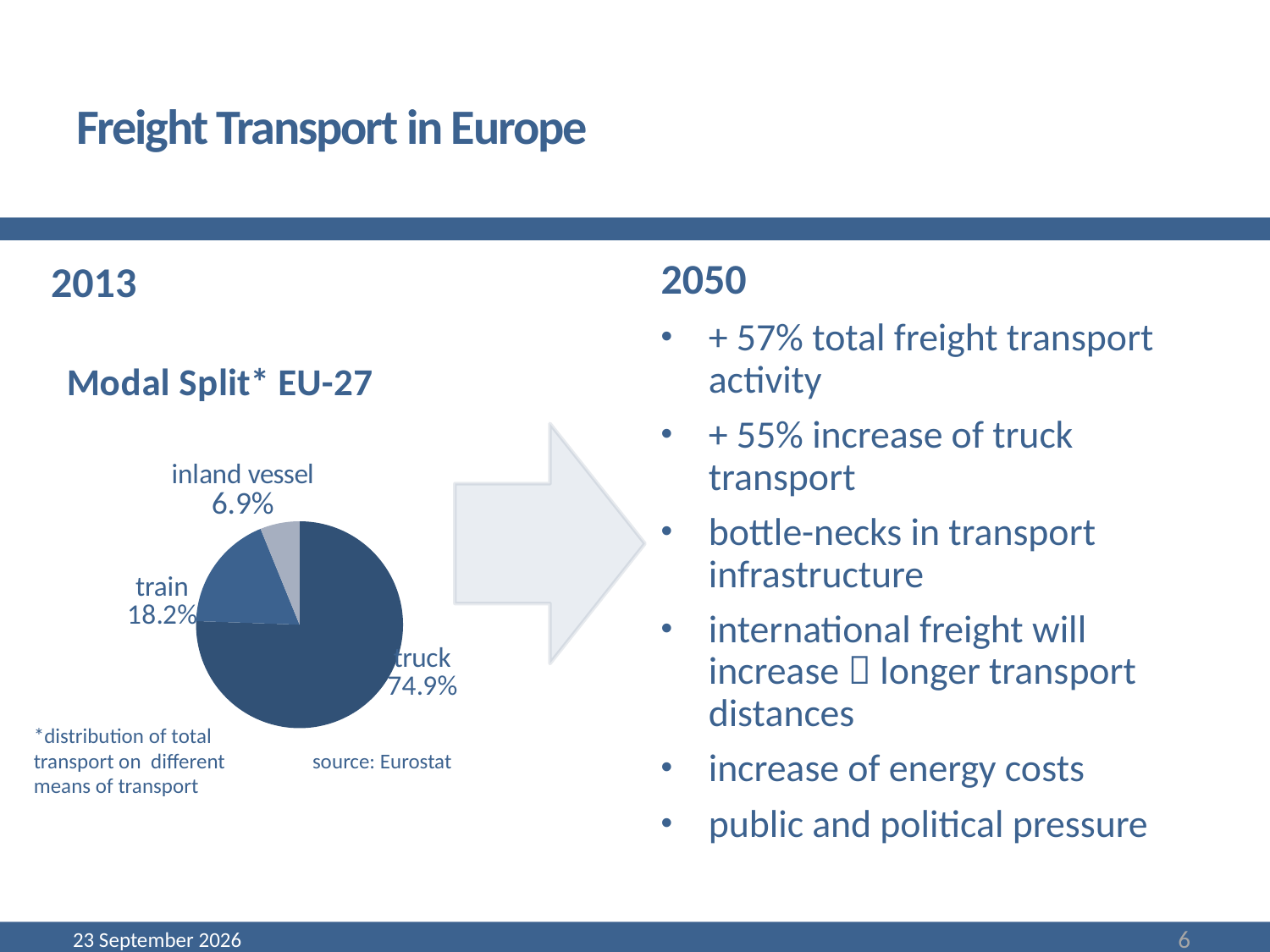
What share of the Modal Split EU-27 pie chart is train? 18.2% What source is cited for the pie chart data? Eurostat What is the difference in percentage points between the train and inland vessel shares in the pie chart? 11.3 What is the difference in percentage points between the truck and train shares in the pie chart? 56.7 What share of the Modal Split EU-27 pie chart is inland vessel? 6.9% Which has a larger share in the pie chart, train or inland vessel? train Which means of transport has the largest share in the Modal Split EU-27 pie chart? truck How many means of transport are shown in the Modal Split EU-27 pie chart? 3 What kind of chart is used to show the Modal Split EU-27? pie chart What share of the Modal Split EU-27 pie chart is truck? 74.9% What is the title of the chart on the slide? Modal Split* EU-27 Which means of transport has the smallest share in the Modal Split EU-27 pie chart? inland vessel